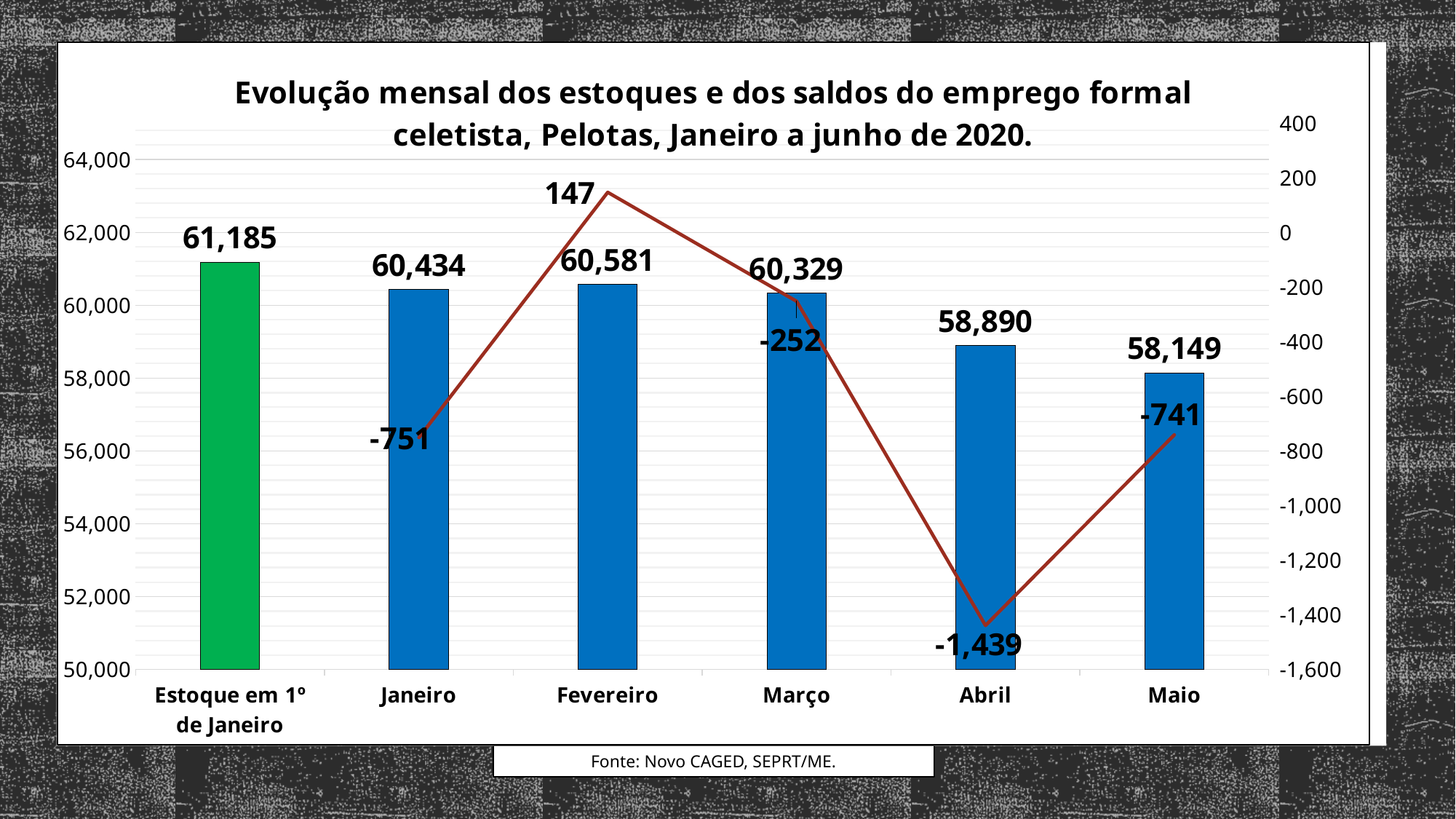
Which month has the highest value on the line (saldo)? Fevereiro What is the value of the line (saldo) for Janeiro? -751 What source is cited below the chart? Fonte: Novo CAGED, SEPRT/ME. What is the bar value for Fevereiro? 60,581 What is the difference between the bar values for Estoque em 1º de Janeiro and Maio? 3,036 What is the bar value for Abril? 58,890 Which month has the lowest bar value? Maio Which is larger, the bar value for Janeiro or for Fevereiro? Fevereiro How many bars are plotted in the chart? 6 Do the bar values rise or fall from Março to Maio? fall What is the value of the line (saldo) for Abril? -1,439 Which category has the highest bar value? Estoque em 1º de Janeiro